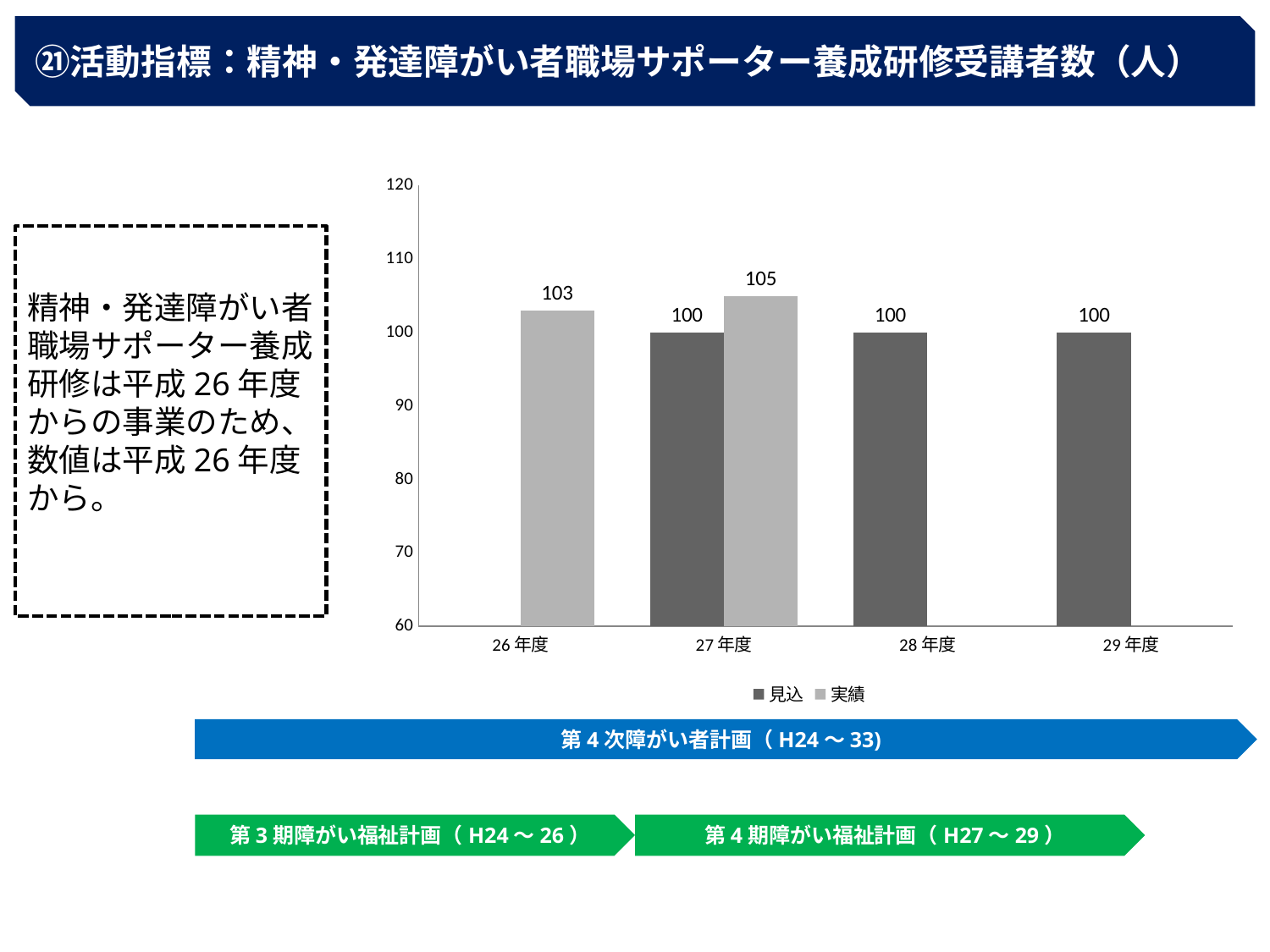
What is the 見込 value for 28年度? 100 What is the difference between the 実績 values for 27年度 and 26年度? 2 Which is larger for 27年度, the 見込 value or the 実績 value? 実績 What is the 実績 value for 27年度? 105 Which year has the highest 実績 value? 27年度 What kind of chart is shown on the slide? bar chart How many series does the legend list? 2 Is the 実績 value for 26年度 greater or less than 100? greater What is the 見込 value for 29年度? 100 What is the difference between the 実績 and 見込 values for 27年度? 5 How many year categories are shown on the x axis? 4 What is the 実績 value for 26年度? 103